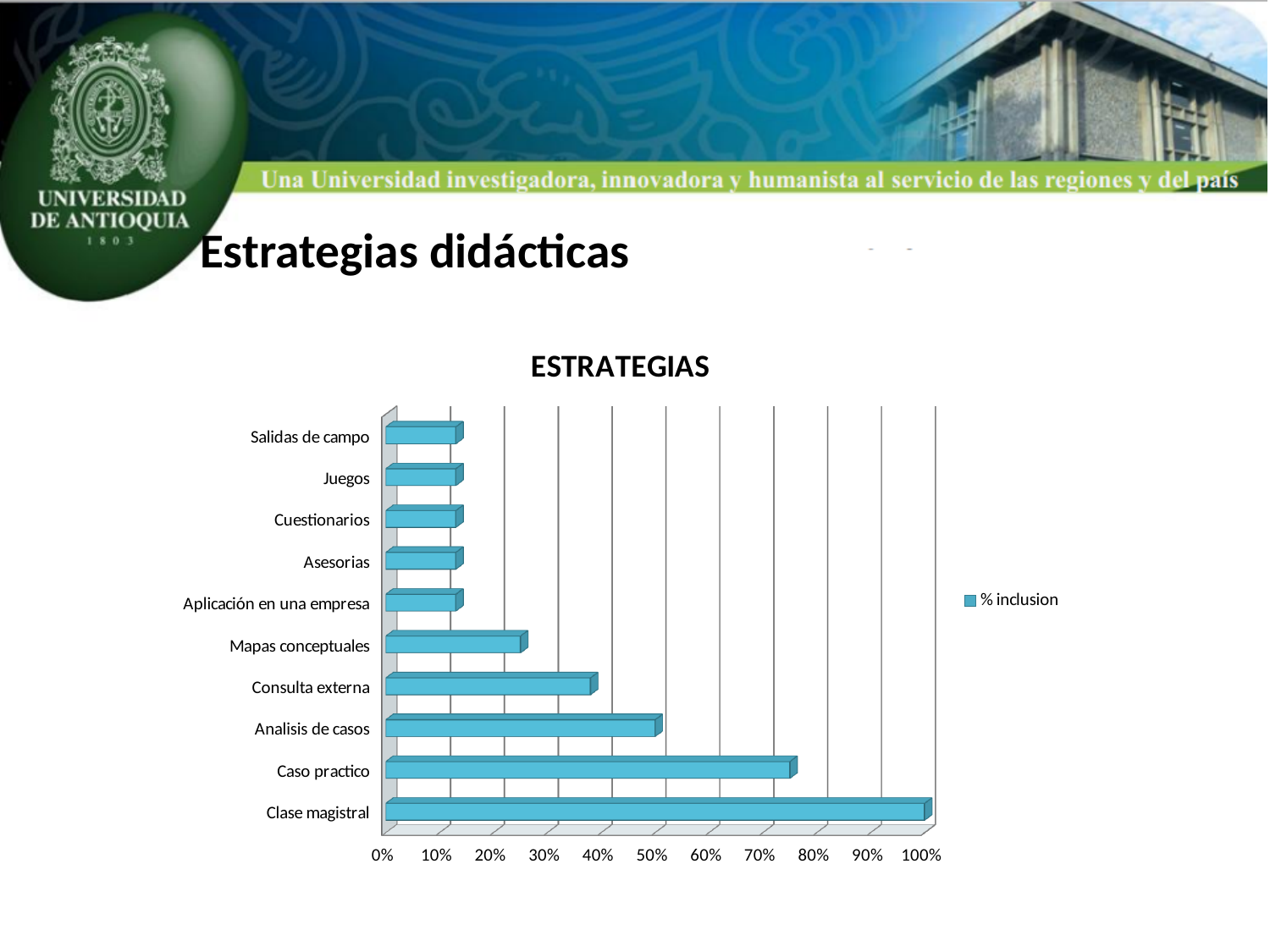
Is the value for Caso practico greater or less than 70%? greater Which category has the highest value? Clase magistral What type of chart is shown on the slide? Bar chart Is the value for Clase magistral greater or less than 90%? greater What is the name of the series shown in the legend? % inclusion How many series does the legend list? 1 Is the value for Salidas de campo greater or less than 20%? less What is the title of the chart? ESTRATEGIAS Which is larger, the value for Caso practico or the value for Analisis de casos? Caso practico How many categories are shown on the chart? 10 Which is larger, the value for Consulta externa or the value for Mapas conceptuales? Consulta externa